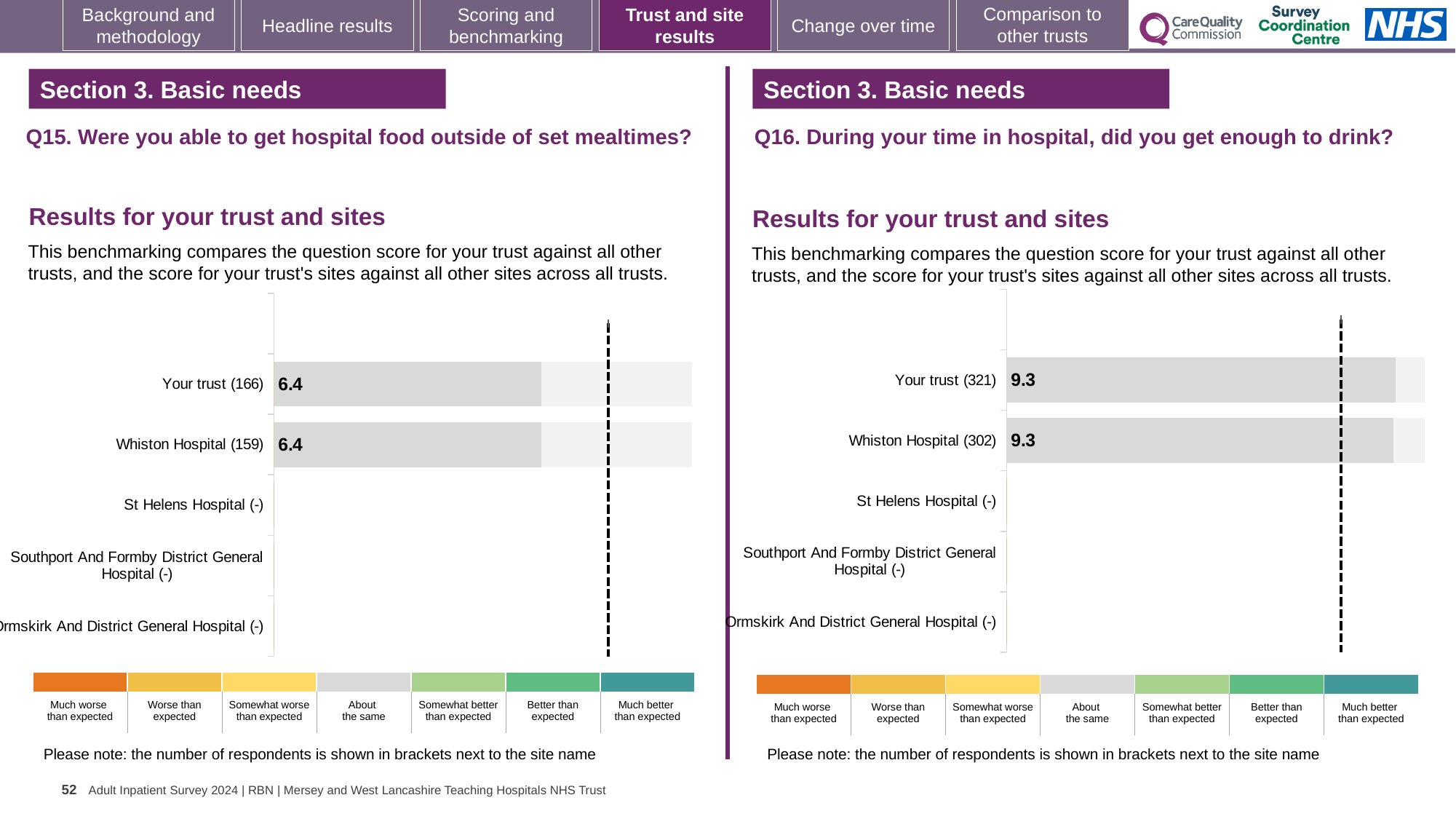
What is the question text shown above the chart on the right? Q16. During your time in hospital, did you get enough to drink? In the Q16 chart on the right, what is the score for Whiston Hospital (302)? 9.3 In the Q15 chart on the left, what is the difference between the score for Your trust and the score for Whiston Hospital? 0 In the Q15 chart on the left, how many categories have a plotted bar with a score? 2 What kind of chart is the Q15 chart on the left? Bar chart In the Q15 chart on the left, what is the score for Whiston Hospital (159)? 6.4 In the Q16 chart on the right, what is the difference between the score for Your trust and the score for Whiston Hospital? 0 How many site/trust categories are listed on the y axis of the Q16 chart on the right? 5 How many site/trust categories are listed on the y axis of the Q15 chart on the left? 5 In the Q16 chart on the right, what is the score for Your trust (321)? 9.3 In the Q16 chart on the right, how many respondents are shown in brackets for Whiston Hospital? 302 In the Q15 chart on the left, what is the score for Your trust (166)? 6.4